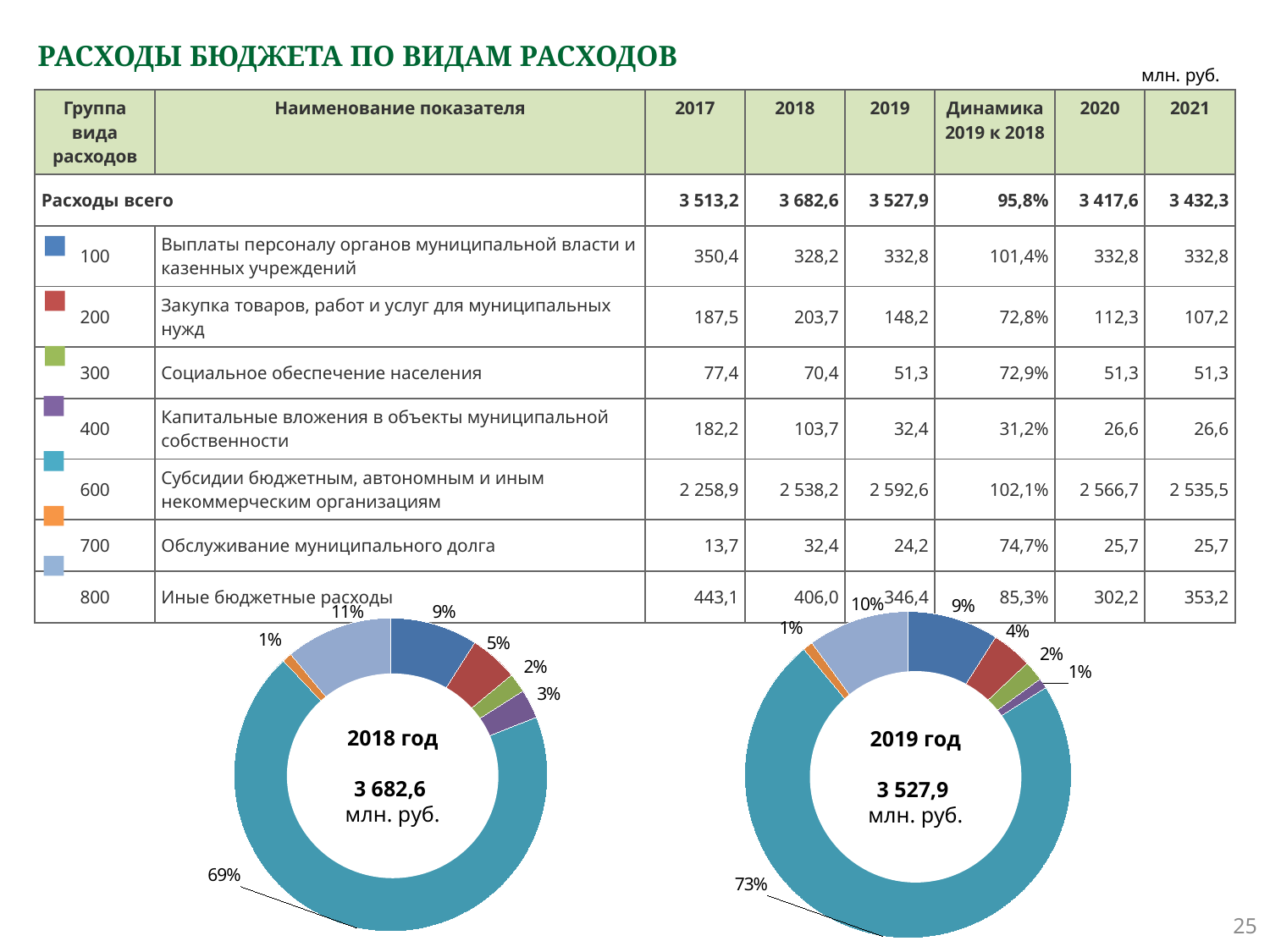
What is the difference between the teal slice share in the 2019 год chart and in the 2018 год chart? 4 percentage points What total amount is printed in the centre of the 2018 год chart? 3 682,6 млн. руб. In the 2018 год chart, what share is shown for the red slice (group 200)? 5% In the 2018 год chart, what share is shown for the dark blue slice (group 100)? 9% In the 2019 год chart, what share does the largest slice have? 73% In the 2018 год chart, what share is shown for the light blue slice (group 800, Иные бюджетные расходы)? 11% Which chart shows a larger share for the teal slice (group 600): 2018 год or 2019 год? 2019 год What kind of chart is used for the 2018 год chart? Pie (donut) chart In the 2018 год chart, what share does the largest slice have? 69% How many slices does the 2019 год chart have? 7